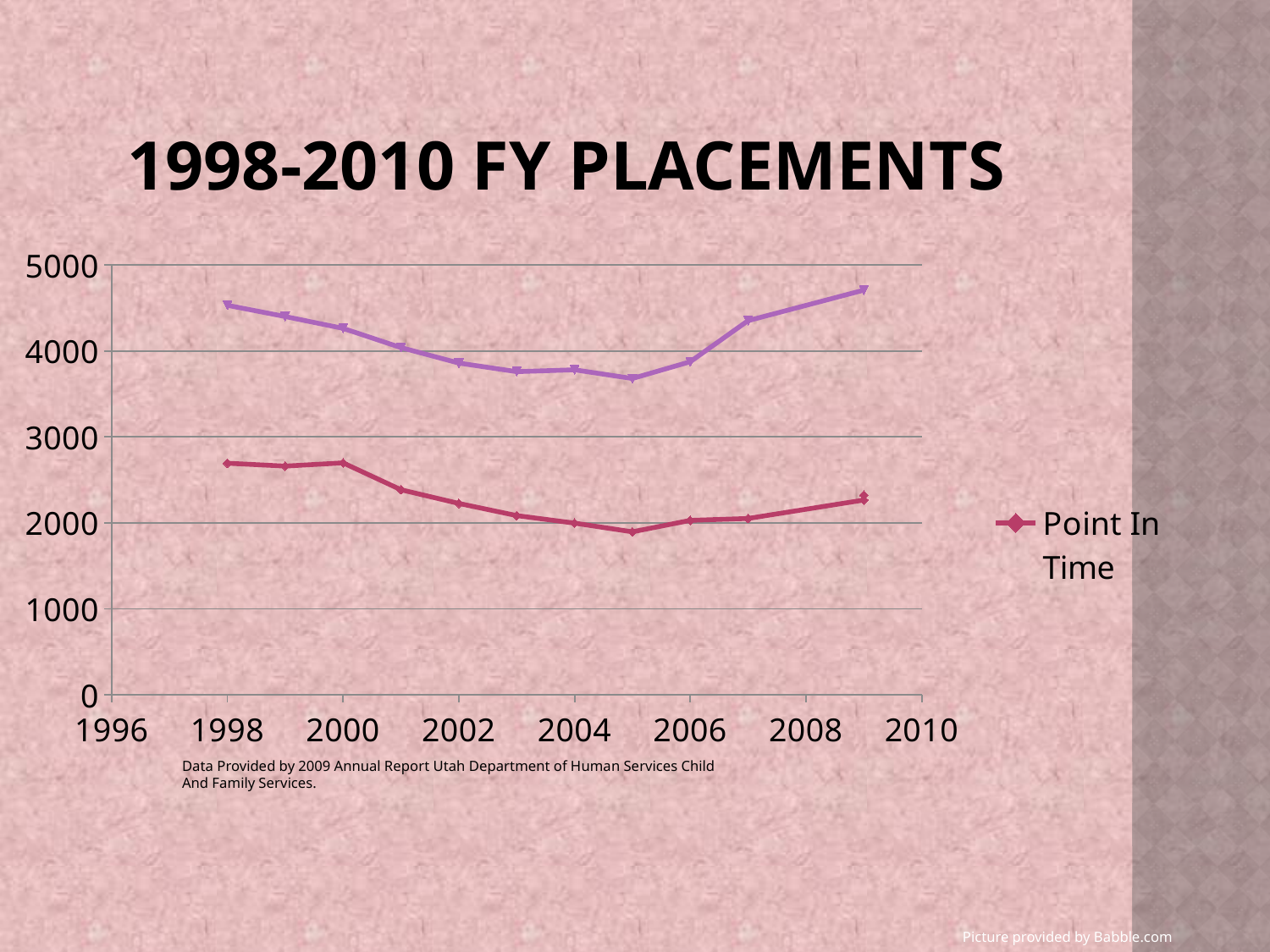
What kind of chart is shown on the slide? line chart Which is larger, the Point In Time value for 1998 or for 2009? 1998 What is the name of the series listed in the legend? Point In Time Is the Point In Time value for 2000 greater or less than 3000? less What is the title of the chart? 1998-2010 FY PLACEMENTS How many data points does the Point In Time line have? 12 Does the Point In Time line rise or fall from 2005 to 2009? rise Is the Point In Time value for 1998 greater or less than 2000? greater Is the Point In Time value for 2005 greater or less than 2000? less Does the Point In Time line rise or fall from 1998 to 2005? fall In which year is the Point In Time value lowest? 2005 How many series does the chart's legend list? 1